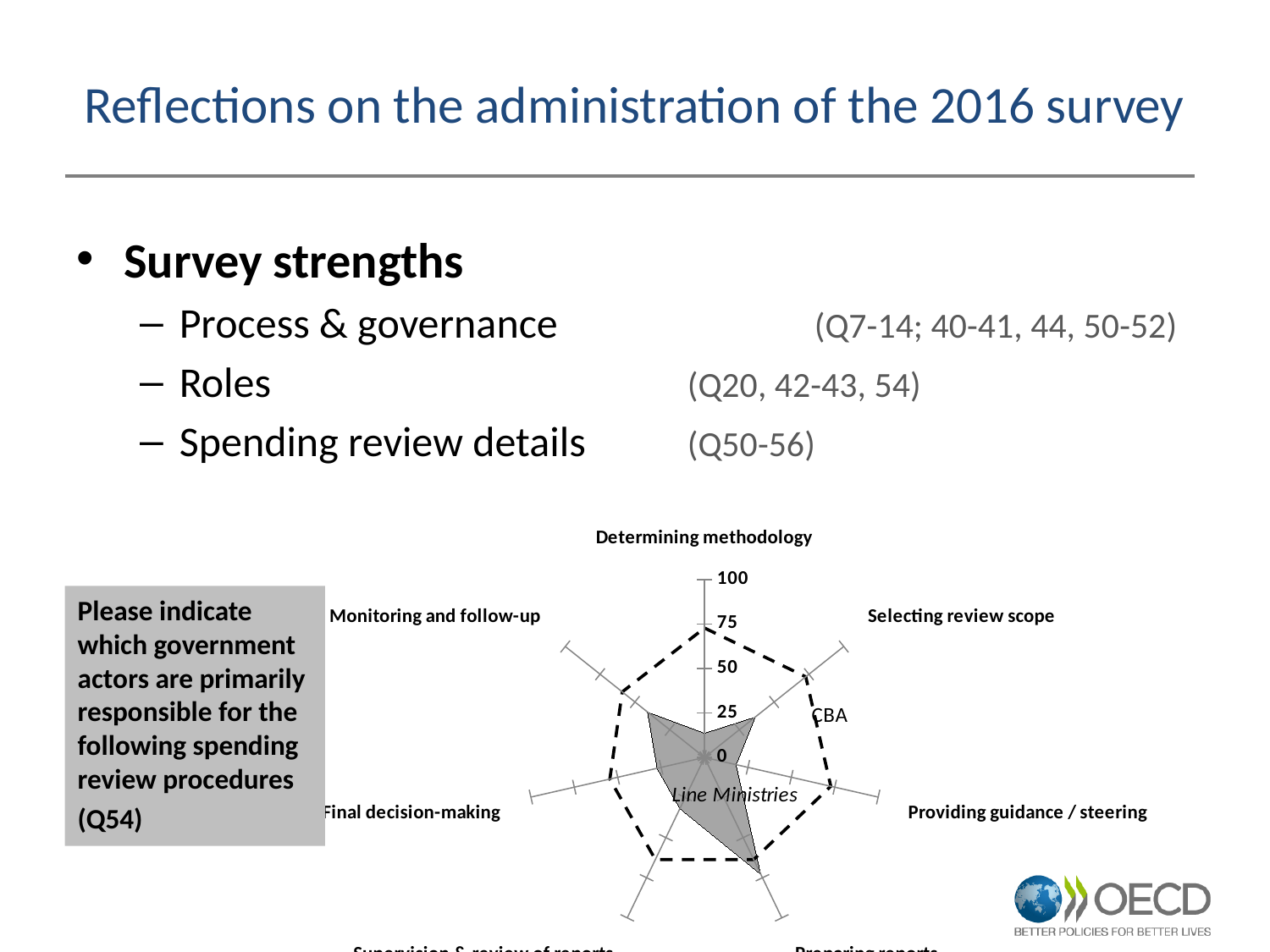
Is the CBA value for Providing guidance / steering greater or less than 50? greater Is the Line Ministries value for Providing guidance / steering greater or less than 25? less For Final decision-making, which series has the larger value, CBA or Line Ministries? CBA What kind of chart is shown on the slide? Radar chart Which series is shown as the grey shaded area? Line Ministries Which series is drawn with a dashed line? CBA What is the highest value shown on the radar chart's axis scale? 100 How many spending review procedures (axes) does the radar chart have? 7 For Determining methodology, which series has the larger value, CBA or Line Ministries? CBA How many series does the chart show? 2